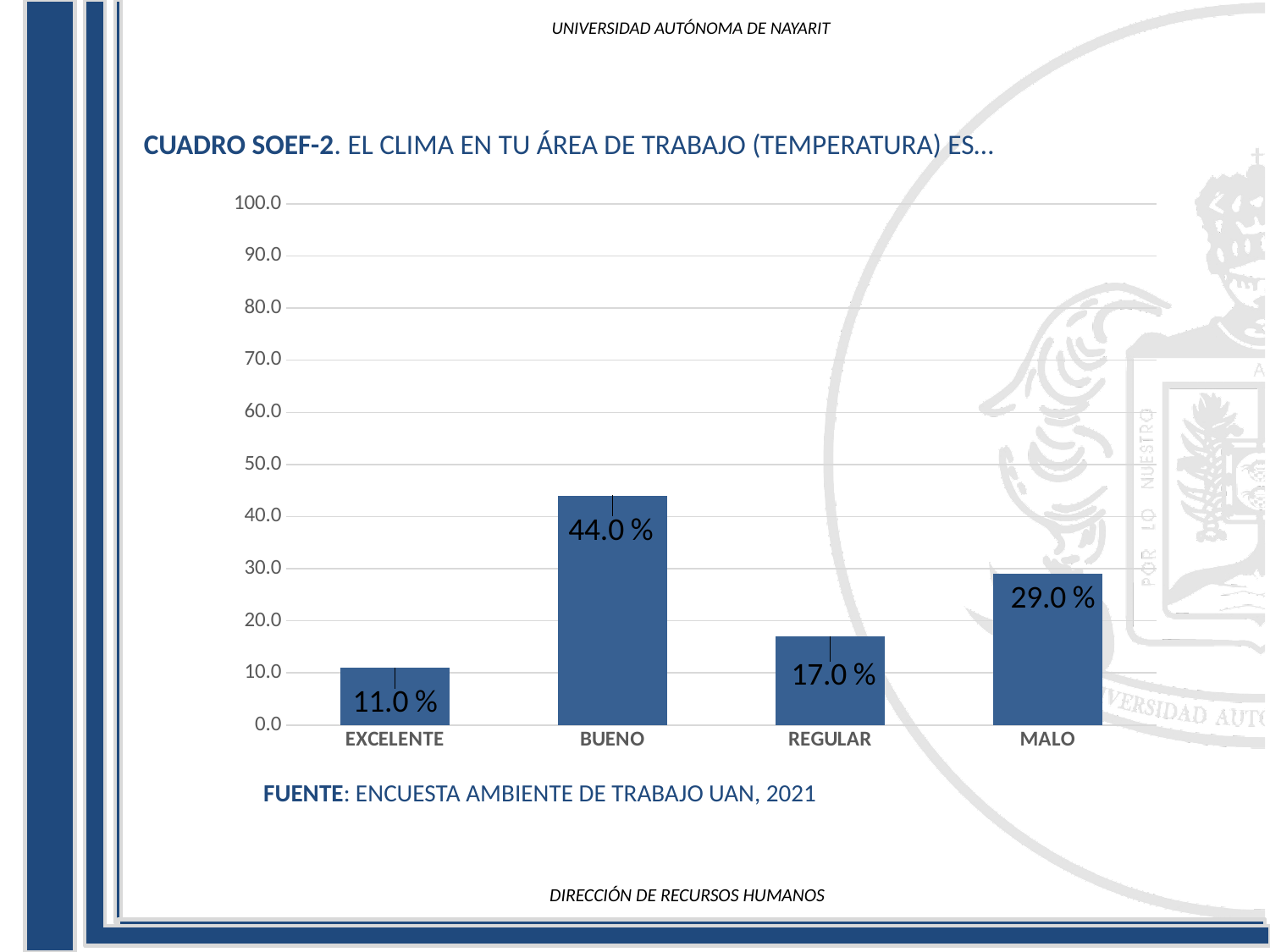
What is the value for BUENO? 44.0 % Which is larger, the value for REGULAR or the value for MALO? MALO What kind of chart is shown on the slide? bar chart What is the value for EXCELENTE? 11.0 % What is the difference between the values for BUENO and MALO? 15.0 % Is the value for BUENO greater or less than 50.0? less What is the value for REGULAR? 17.0 % How many categories are shown on the x axis? 4 What is the value for MALO? 29.0 % What source is cited below the chart? ENCUESTA AMBIENTE DE TRABAJO UAN, 2021 Which category has the highest value? BUENO Which category has the lowest value? EXCELENTE